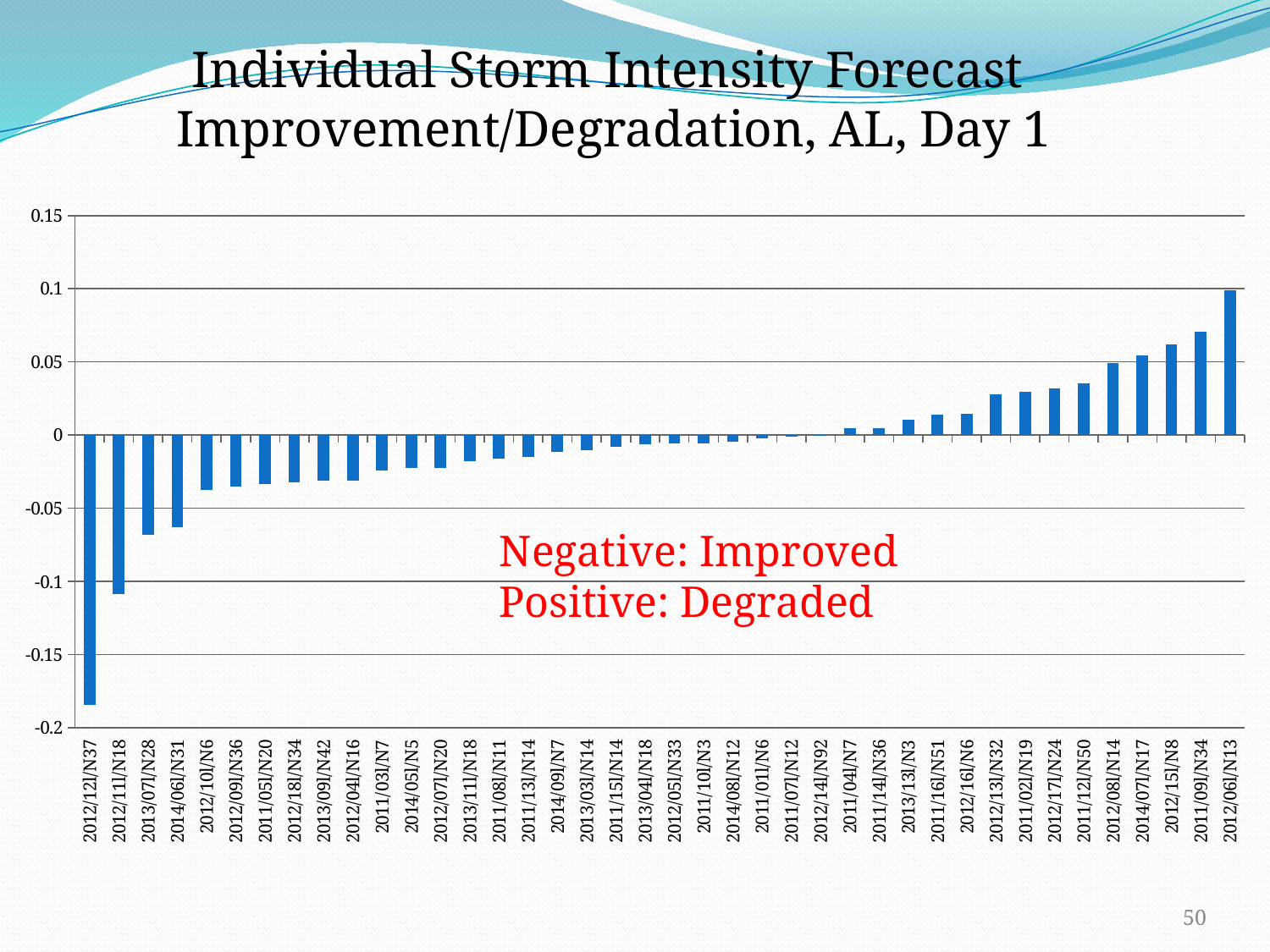
Do the bar values rise or fall moving from left to right along the x axis? rise Is the value for 2012/12l/N37 greater or less than -0.15? less According to the annotation on the chart, what does a negative value indicate? Improved Which has the larger value, 2012/12l/N37 or 2012/11l/N18? 2012/11l/N18 What kind of chart is shown on the slide? bar chart Is the value for 2011/09l/N34 greater or less than 0.05? greater What is the title of the chart? Individual Storm Intensity Forecast Improvement/Degradation, AL, Day 1 Which storm has the lowest (most negative) value? 2012/12l/N37 Which storm has the highest value? 2012/06l/N13 How many storms (categories) are plotted on the x axis? 40 Is the value for 2012/10l/N6 greater or less than -0.05? greater